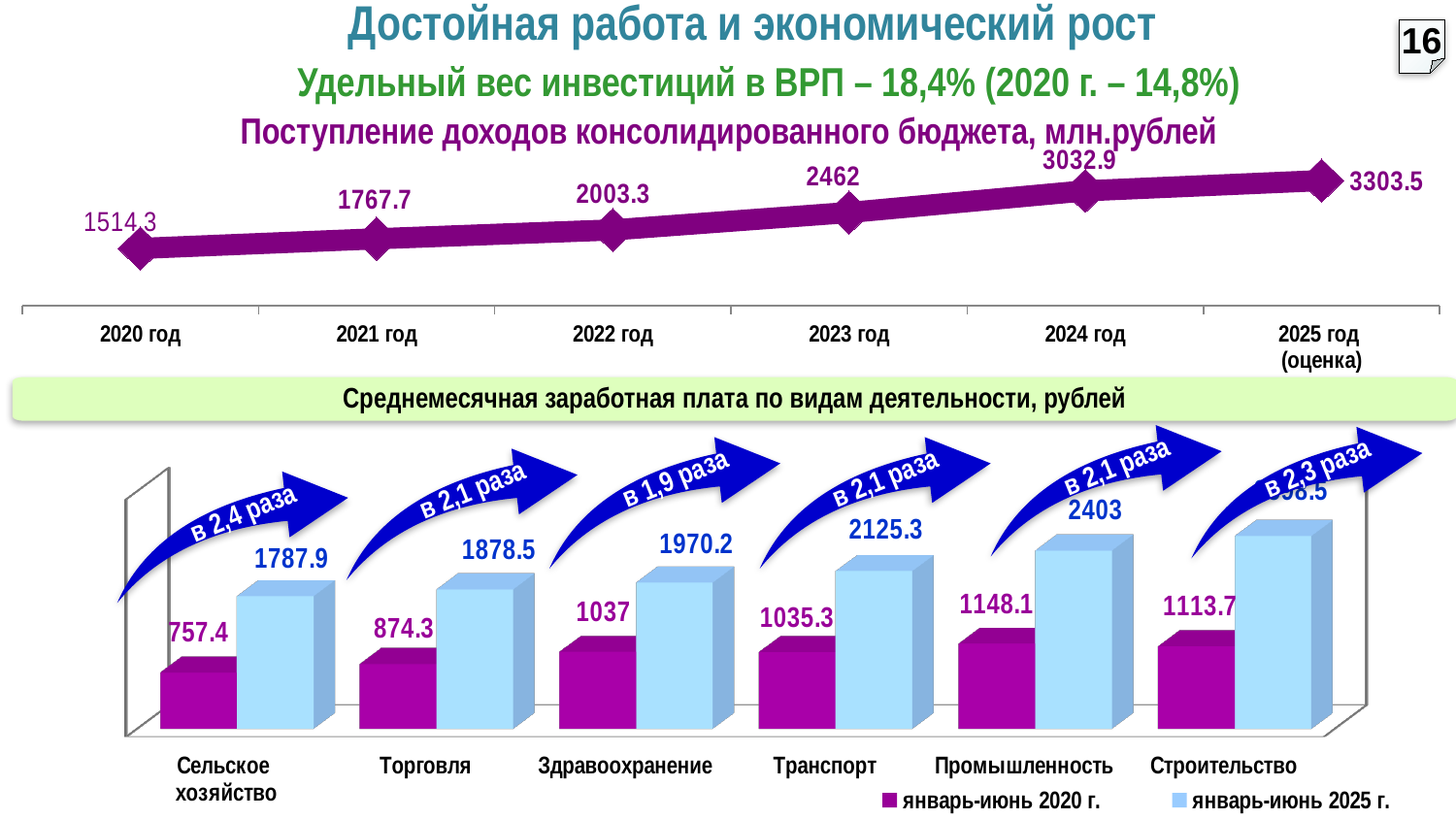
On the chart 'Поступление доходов консолидированного бюджета, млн.рублей', what is the value for 2025 год (оценка)? 3303.5 On the chart 'Поступление доходов консолидированного бюджета, млн.рублей', which year has the lowest value? 2020 год On the chart 'Среднемесячная заработная плата по видам деятельности, рублей', what is the value for Транспорт in январь-июнь 2025 г.? 2125.3 What kind of chart is 'Среднемесячная заработная плата по видам деятельности, рублей'? bar chart On the chart 'Поступление доходов консолидированного бюджета, млн.рублей', what is the difference between the 2024 год and 2023 год values? 570.9 On the chart 'Среднемесячная заработная плата по видам деятельности, рублей', which category has the highest value for январь-июнь 2020 г.? Промышленность On the chart 'Поступление доходов консолидированного бюджета, млн.рублей', do the values rise or fall from 2020 год to 2025 год? rise On the chart 'Поступление доходов консолидированного бюджета, млн.рублей', what is the value for 2022 год? 2003.3 On the chart 'Среднемесячная заработная плата по видам деятельности, рублей', how many series does the legend list? 2 On the chart 'Поступление доходов консолидированного бюджета, млн.рублей', how many years are plotted? 6 On the chart 'Среднемесячная заработная плата по видам деятельности, рублей', which is larger for январь-июнь 2025 г.: Торговля or Здравоохранение? Здравоохранение On the chart 'Среднемесячная заработная плата по видам деятельности, рублей', what is the value for Сельское хозяйство in январь-июнь 2020 г.? 757.4